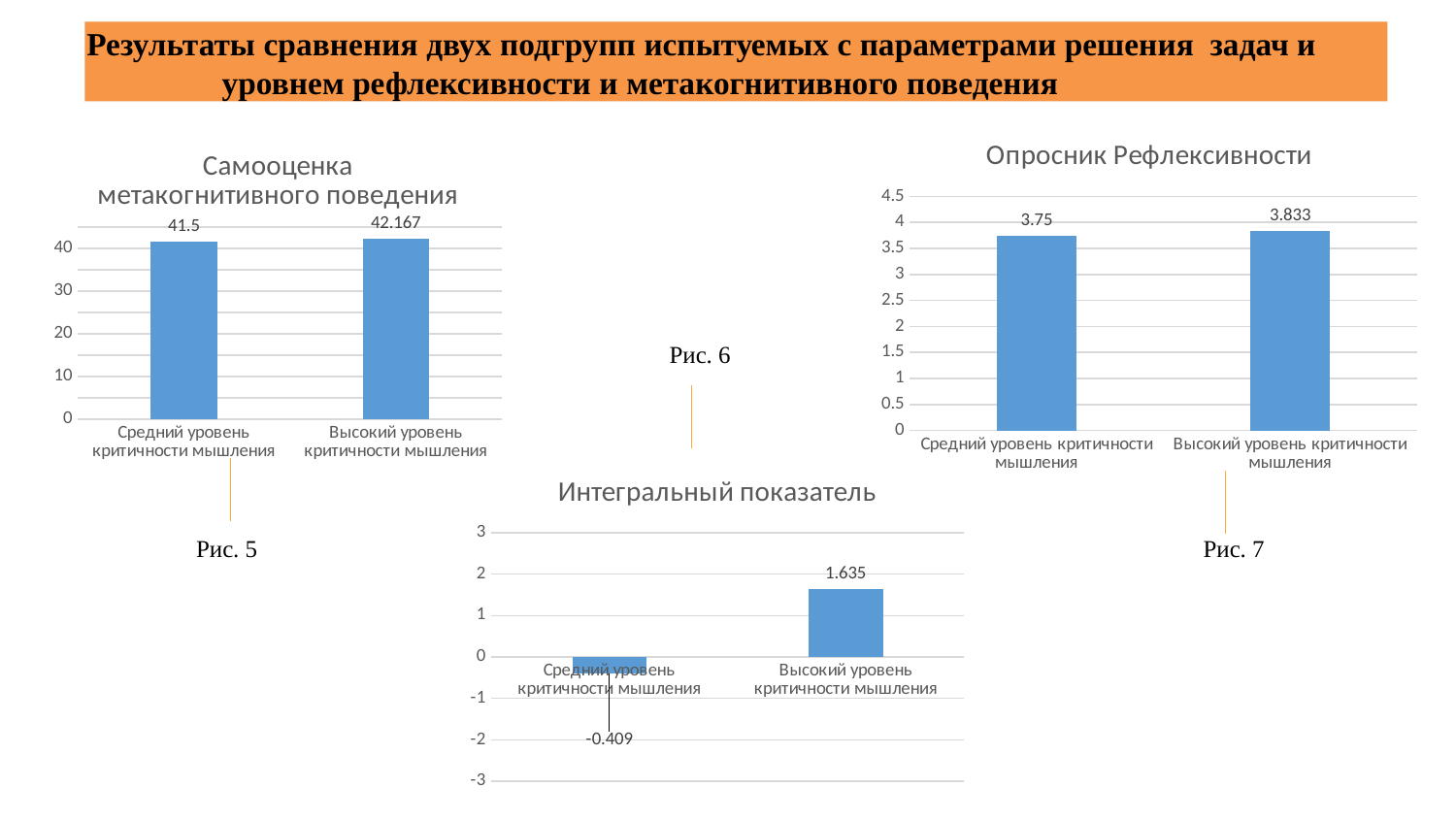
What kind of chart is the one titled "Интегральный показатель"? bar chart In the chart titled "Опросник Рефлексивности", is the value for "Средний уровень критичности мышления" greater or less than 4? less How many charts are shown on the slide? 3 In the chart titled "Самооценка метакогнитивного поведения", what is the difference between the values for "Высокий уровень критичности мышления" and "Средний уровень критичности мышления"? 0.667 In the chart titled "Интегральный показатель", what is the value for "Высокий уровень критичности мышления"? 1.635 In the chart titled "Интегральный показатель", what is the difference between the values for "Высокий уровень критичности мышления" and "Средний уровень критичности мышления"? 2.044 In the chart titled "Интегральный показатель", which category has the highest value? Высокий уровень критичности мышления In the chart titled "Самооценка метакогнитивного поведения", what is the value for "Средний уровень критичности мышления"? 41.5 In the chart titled "Опросник Рефлексивности", what is the value for "Высокий уровень критичности мышления"? 3.833 In the chart titled "Интегральный показатель", what is the value for "Средний уровень критичности мышления"? -0.409 In the chart titled "Опросник Рефлексивности", what is the value for "Средний уровень критичности мышления"? 3.75 In the chart titled "Самооценка метакогнитивного поведения", what is the value for "Высокий уровень критичности мышления"? 42.167